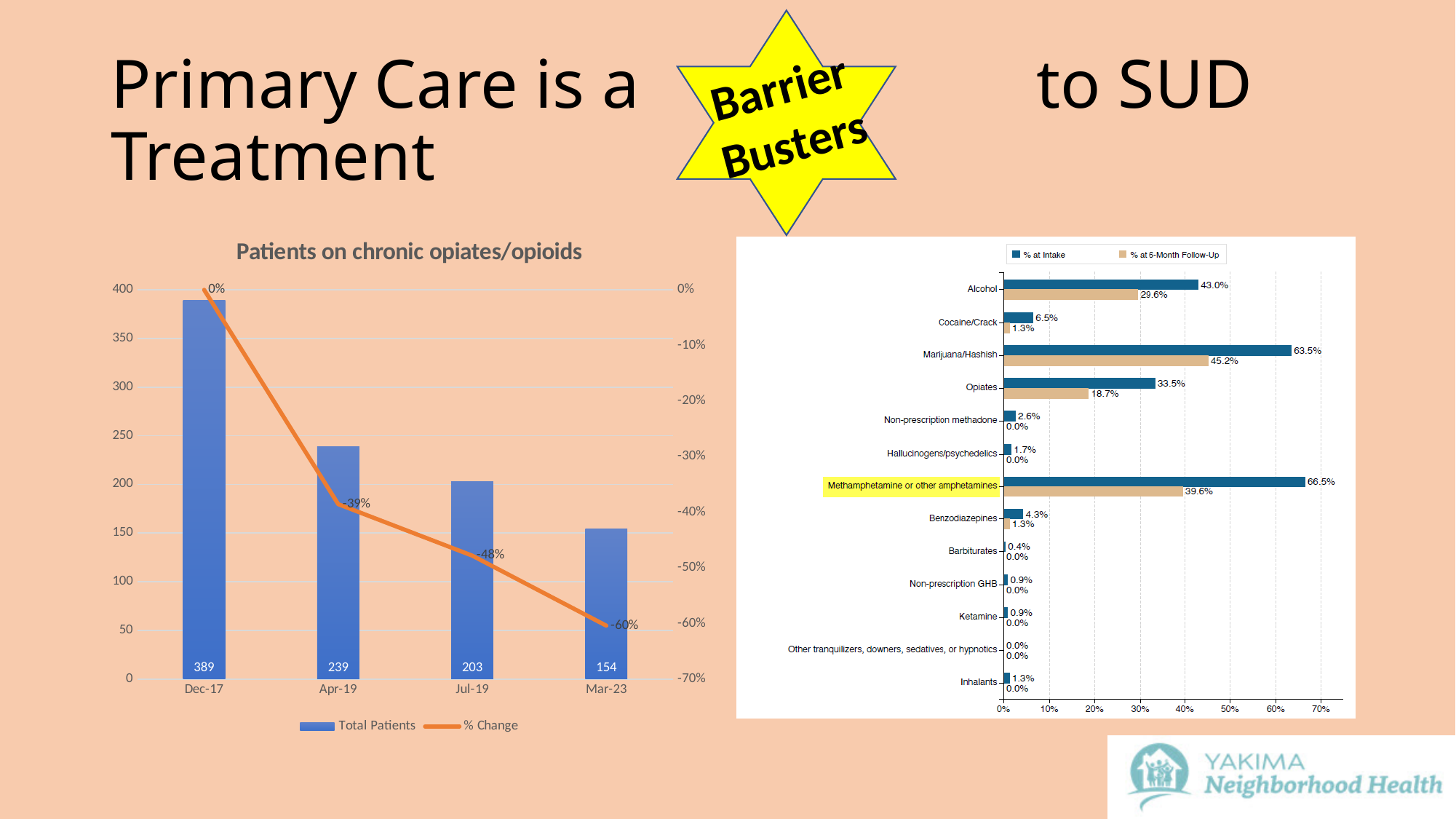
In the 'Patients on chronic opiates/opioids' chart, how many series does the legend list? 2 In the chart on the right, what is the difference between % at Intake and % at 6-Month Follow-Up for Opiates? 14.8% In the 'Patients on chronic opiates/opioids' chart, what is the difference in Total Patients between Dec-17 and Apr-19? 150 In the 'Patients on chronic opiates/opioids' chart, what is the % Change value for Mar-23? -60% In the 'Patients on chronic opiates/opioids' chart, what is the Total Patients value for Dec-17? 389 In the chart on the right, what is the % at Intake for Alcohol? 43.0% In the chart on the right, which substance has the highest % at Intake? Methamphetamine or other amphetamines In the chart on the right, how many substance categories are listed? 13 In the 'Patients on chronic opiates/opioids' chart, which period has the lowest Total Patients? Mar-23 In the chart on the right, which is larger: the % at Intake for Cocaine/Crack or for Benzodiazepines? Cocaine/Crack In the chart on the right, what is the % at 6-Month Follow-Up for Marijuana/Hashish? 45.2% In the 'Patients on chronic opiates/opioids' chart, do the Total Patients values rise or fall from Dec-17 to Mar-23? fall